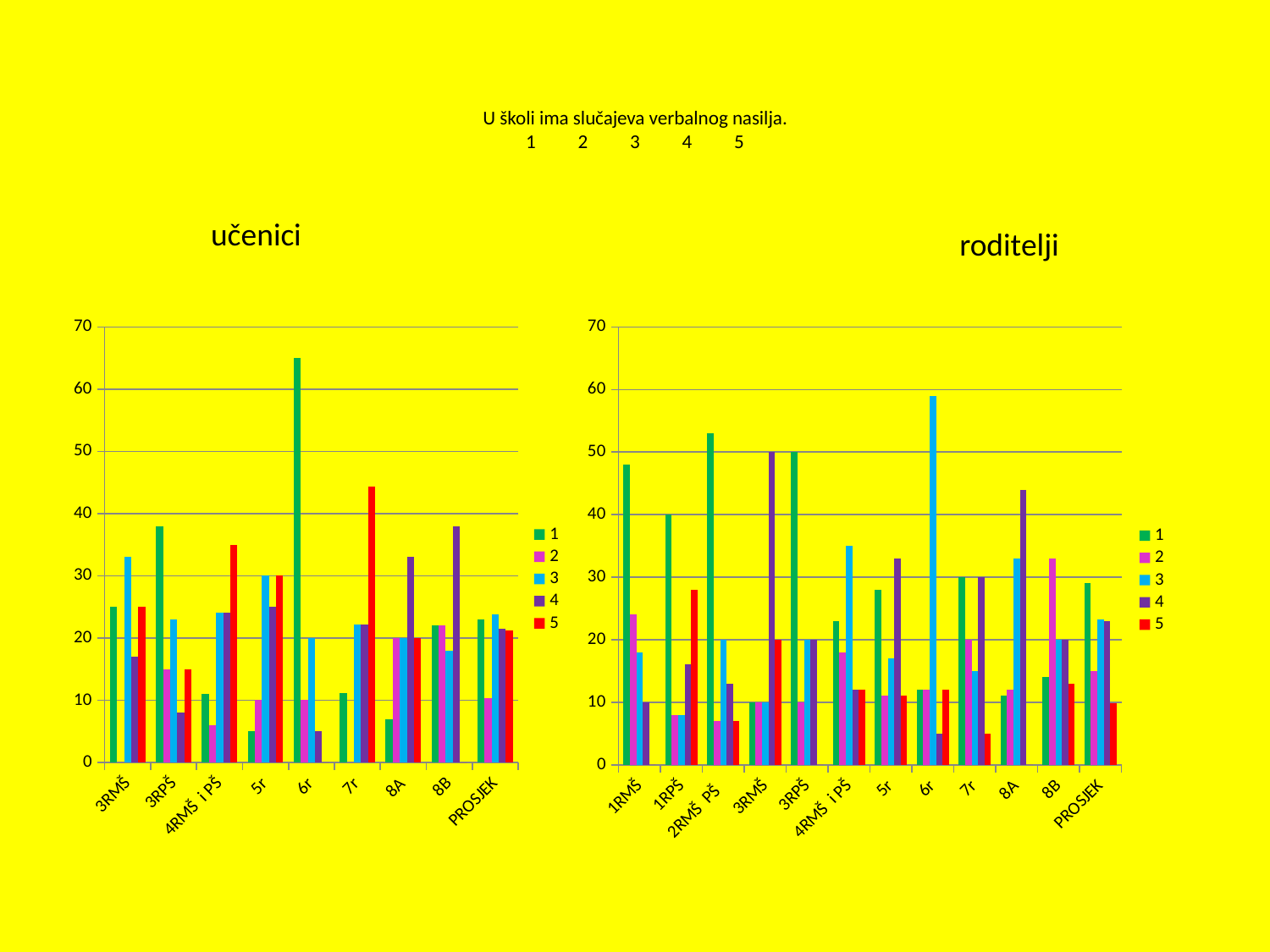
What is the title of the chart on the right side of the slide? roditelji How many categories are shown on the x axis of the 'roditelji' chart? 12 In the 'učenici' chart, which is larger: series 1 for 6r or series 5 for 7r? series 1 for 6r In the 'učenici' chart, is the value of series 5 for 7r greater or less than 40? greater What kind of chart is the 'učenici' chart on the left? bar chart How many categories are shown on the x axis of the 'učenici' chart? 9 How many series does the legend of the 'roditelji' chart list? 5 In the 'učenici' chart, which category has the tallest bar for series 1? 6r In the 'roditelji' chart, is the value of series 1 for 2RMŠ PŠ greater or less than 50? greater In the 'roditelji' chart, which category has the tallest bar for series 3? 6r In the 'učenici' chart, is the value of series 1 for 6r greater or less than 60? greater